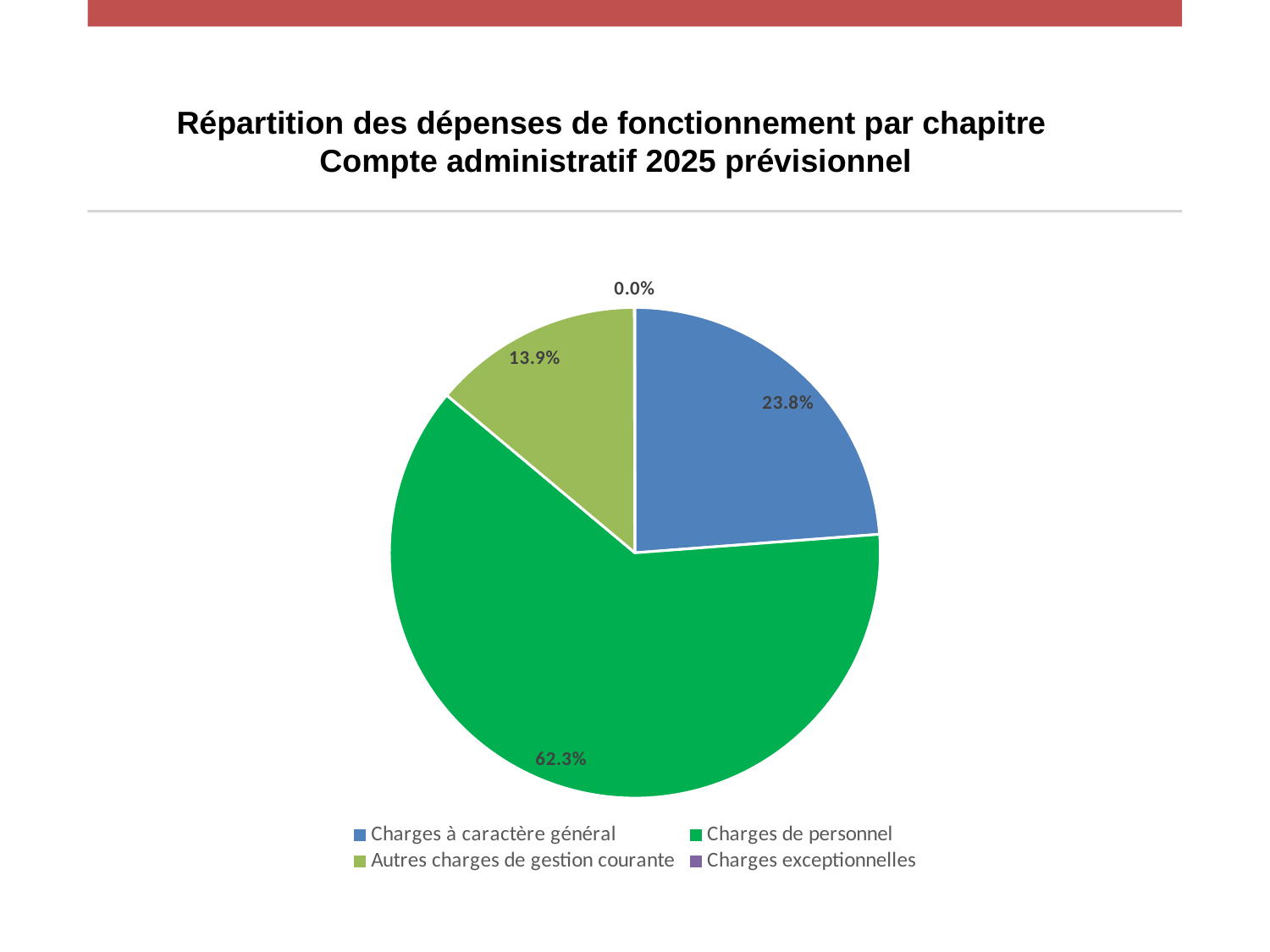
What is the title of the chart? Répartition des dépenses de fonctionnement par chapitre Compte administratif 2025 prévisionnel What colour is the slice for Charges de personnel? Green What share of the pie does Charges exceptionnelles represent? 0.0% What is the difference in percentage points between Charges de personnel and Charges à caractère général? 38.5 What share of the pie does Charges de personnel represent? 62.3% Which category has the largest slice of the pie? Charges de personnel Which is larger, Charges à caractère général or Autres charges de gestion courante? Charges à caractère général What kind of chart is shown on the slide? Pie chart Which category has the smallest slice of the pie? Charges exceptionnelles What share of the pie does Charges à caractère général represent? 23.8% How many categories does the legend list? 4